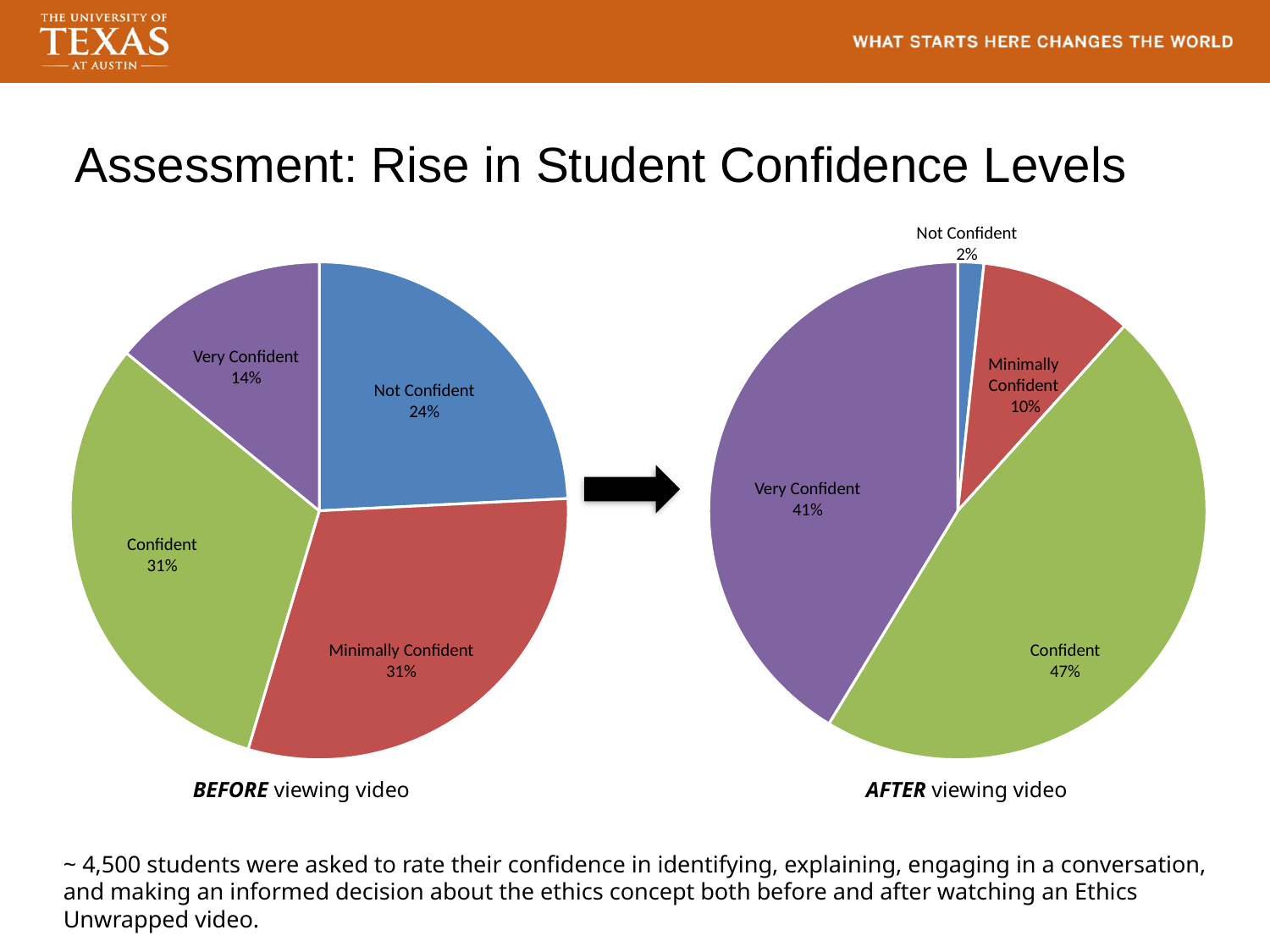
In the BEFORE viewing video pie chart, what is the difference between the Confident share and the Very Confident share? 17 percentage points In the AFTER viewing video pie chart, what colour is the Confident slice? Green How many categories does the BEFORE viewing video pie chart show? 4 In the BEFORE viewing video pie chart, what share of students were Not Confident? 24% In the AFTER viewing video pie chart, which category has the largest share? Confident In the AFTER viewing video pie chart, what share of students were Very Confident? 41% What is the difference between the Very Confident share in the AFTER chart and the Very Confident share in the BEFORE chart? 27 percentage points Which is larger: the Minimally Confident share in the BEFORE chart or the Minimally Confident share in the AFTER chart? BEFORE chart What type of chart is used on this slide? Pie chart In the BEFORE viewing video pie chart, which category has the smallest share? Very Confident In the AFTER viewing video pie chart, what share of students were Not Confident? 2% In the AFTER viewing video pie chart, which category has the smallest share? Not Confident